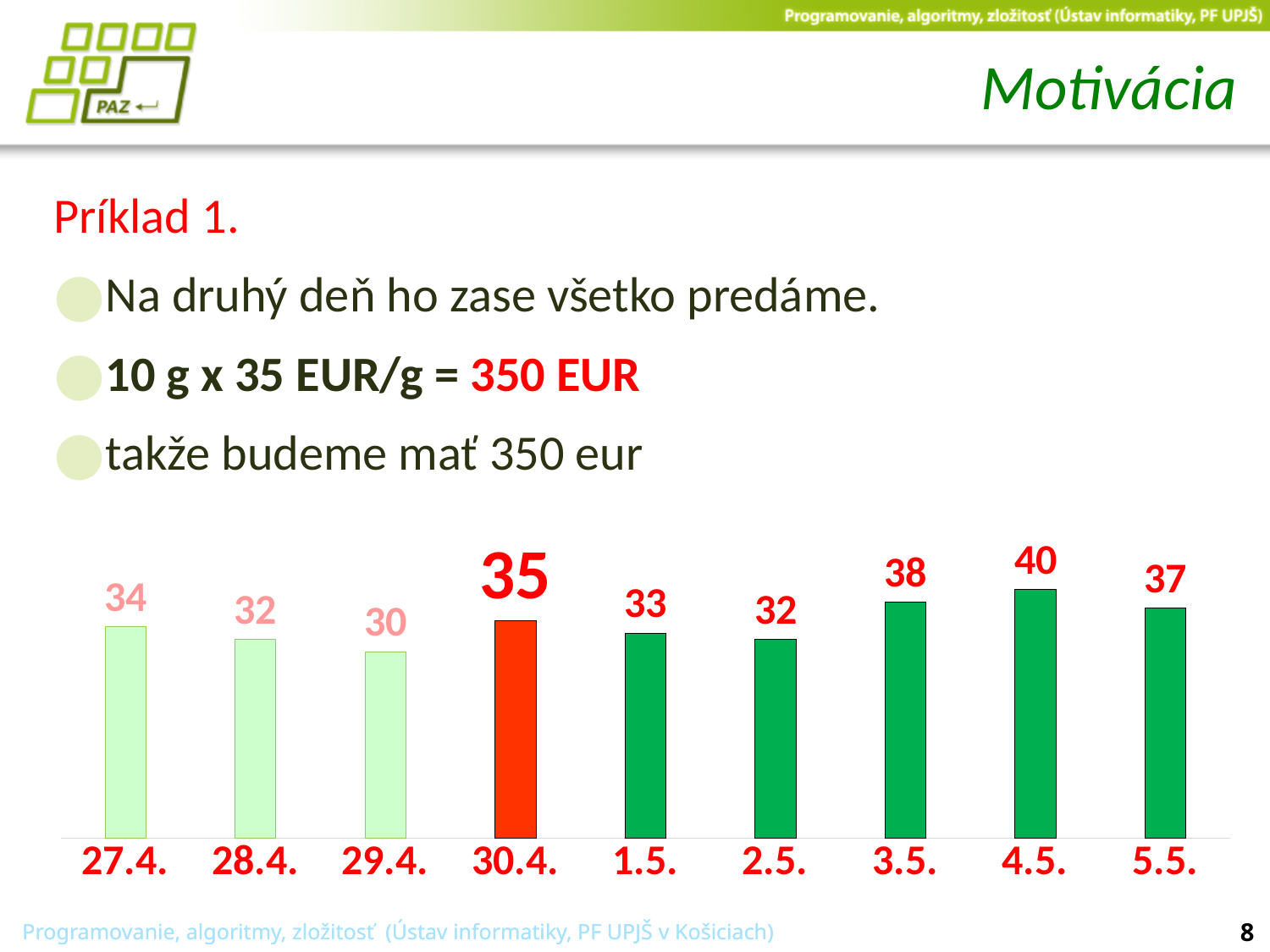
Which is larger, the value for 3.5. or the value for 5.5.? 3.5. What is the value for 4.5.? 40 Which date has the highest value? 4.5. Which bar is coloured red? 30.4. What is the value for 29.4.? 30 Which date has the lowest value? 29.4. How many dates are shown on the x axis? 9 What is the difference between the values for 27.4. and 28.4.? 2 What kind of chart is shown on the slide? bar chart Do the values rise or fall from 27.4. to 29.4.? fall What is the value for 30.4.? 35 What is the difference between the values for 4.5. and 30.4.? 5